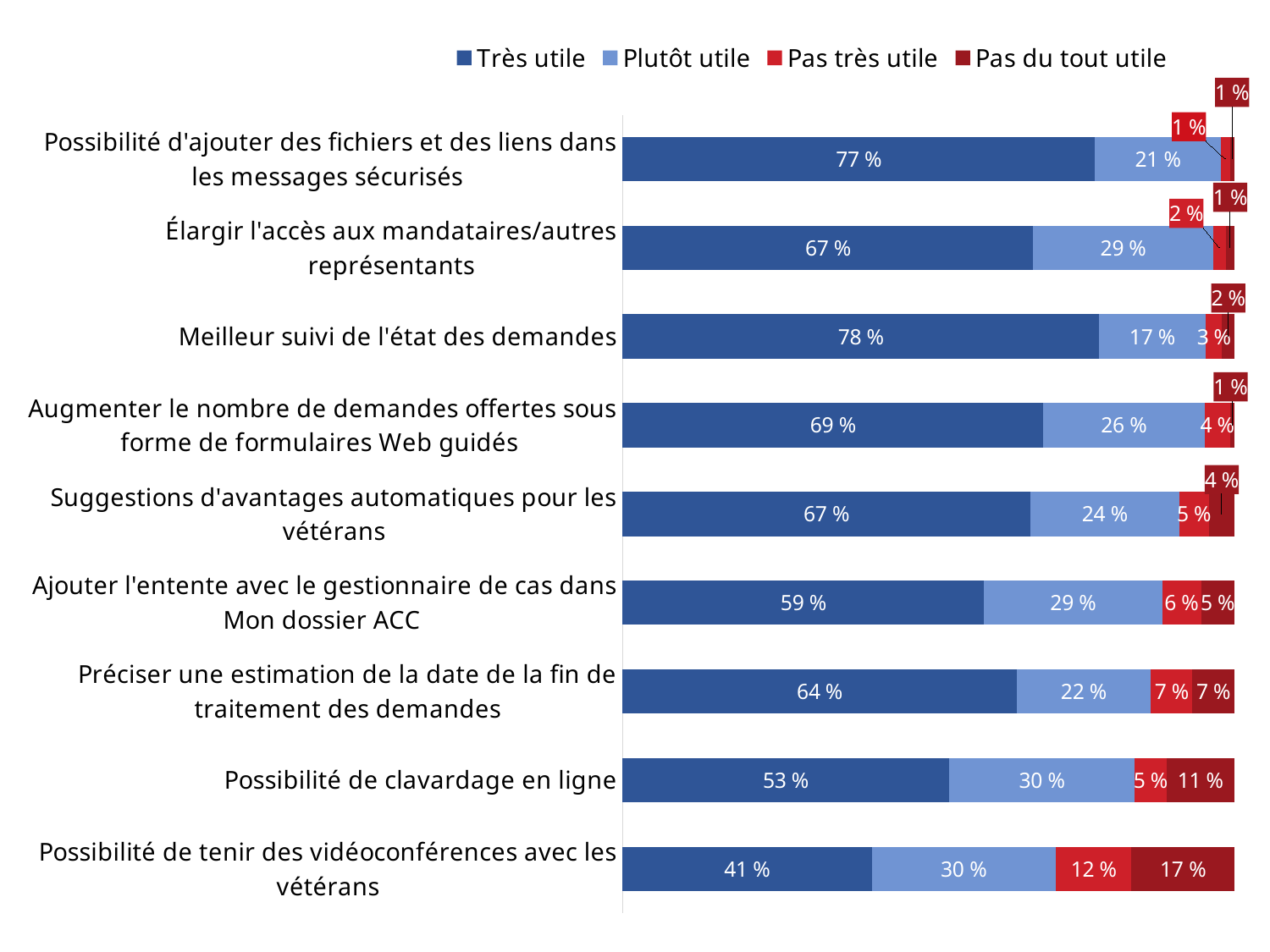
How many series does the legend list? 4 What is the difference between the "Très utile" values for "Possibilité d'ajouter des fichiers et des liens dans les messages sécurisés" and "Possibilité de clavardage en ligne"? 24 % Which category has the lowest "Très utile" value? Possibilité de tenir des vidéoconférences avec les vétérans How many categories are plotted in the chart? 9 Which is larger: the "Pas du tout utile" value for "Possibilité de clavardage en ligne" or for "Préciser une estimation de la date de la fin de traitement des demandes"? Possibilité de clavardage en ligne Which legend entry is shown in the darkest red colour? Pas du tout utile What is the total of the stacked bar for "Possibilité de tenir des vidéoconférences avec les vétérans"? 100 % Which category has the highest "Très utile" value? Meilleur suivi de l'état des demandes What is the "Plutôt utile" value for "Élargir l'accès aux mandataires/autres représentants"? 29 % What is the "Très utile" value for "Possibilité de clavardage en ligne"? 53 % What is the "Pas du tout utile" value for "Possibilité de tenir des vidéoconférences avec les vétérans"? 17 % What type of chart is shown on the slide? Stacked bar chart